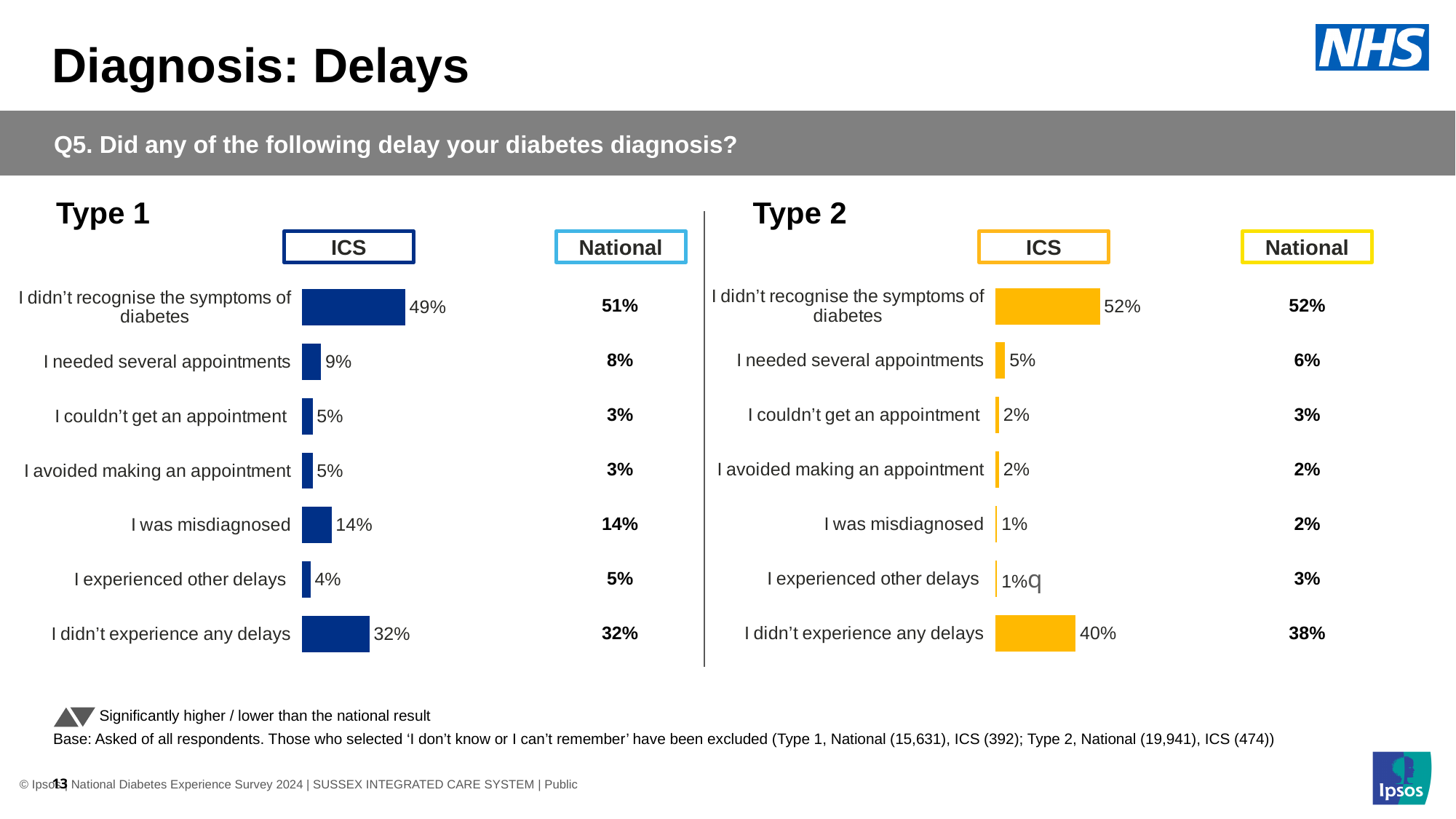
What colour are the ICS bars on the Type 2 chart? yellow/orange On the Type 1 chart, which category has the highest ICS value? I didn't recognise the symptoms of diabetes How many categories are shown on the Type 2 chart? 7 On the Type 2 chart, what is the National value for 'I needed several appointments'? 6% On the Type 2 chart, what is the ICS value for 'I didn't experience any delays'? 40% What type of chart is used for the ICS values on the Type 1 side? bar chart On the Type 1 chart, is the ICS value for 'I needed several appointments' larger or smaller than the ICS value for 'I was misdiagnosed'? smaller On the Type 2 chart, what is the difference between the ICS and National values for 'I didn't experience any delays'? 2 percentage points On the Type 1 chart, what is the difference between the ICS values for 'I didn't recognise the symptoms of diabetes' and 'I didn't experience any delays'? 17 percentage points On the Type 1 chart, what is the ICS value for 'I didn't recognise the symptoms of diabetes'? 49% On the Type 1 chart, what is the National value for 'I was misdiagnosed'? 14% On the Type 2 chart, which category has the highest ICS value? I didn't recognise the symptoms of diabetes